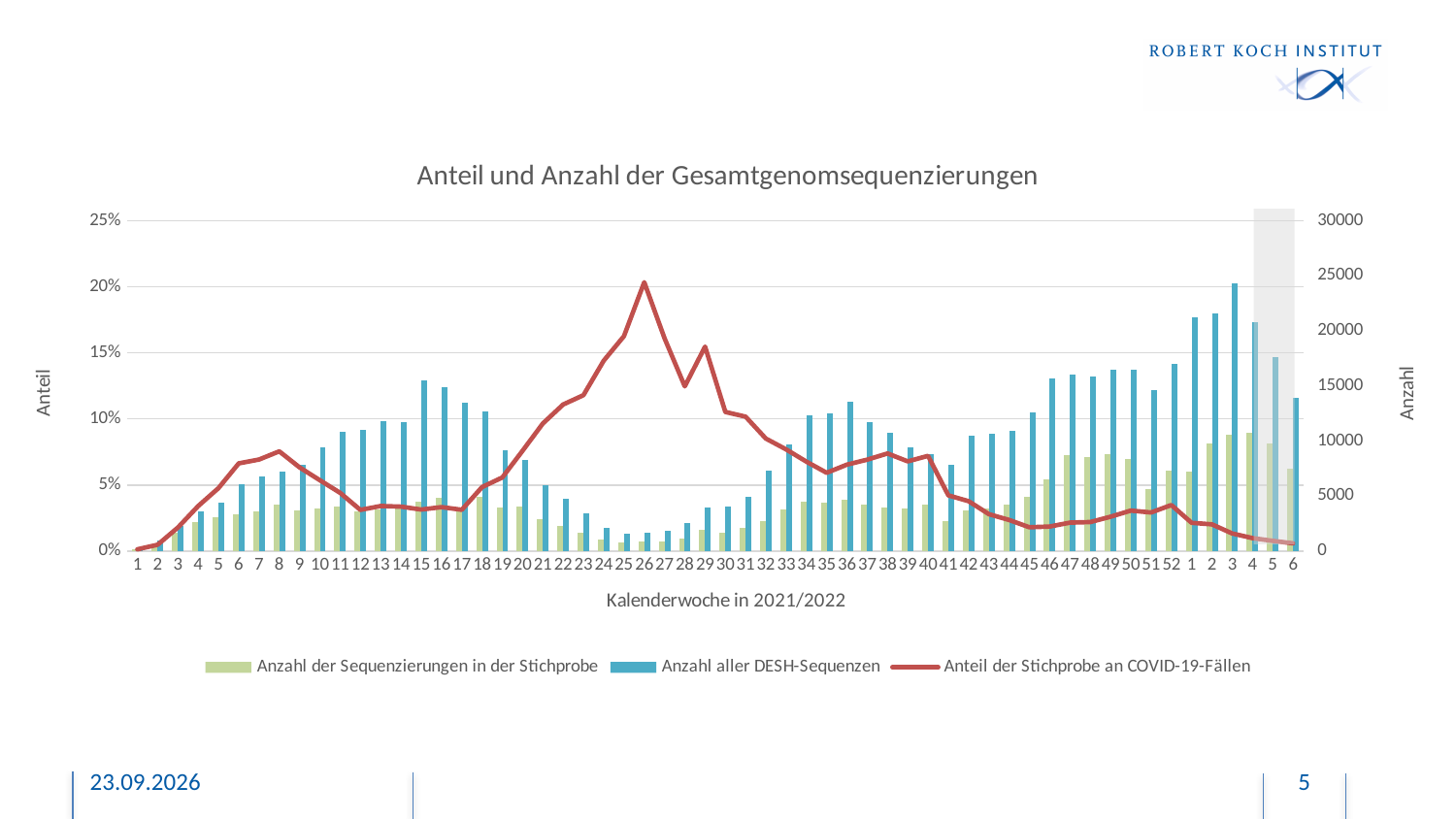
Which series is drawn as a red line? Anteil der Stichprobe an COVID-19-Fällen Is the value of 'Anteil der Stichprobe an COVID-19-Fällen' in calendar week 26 greater or less than 15%? greater Does the line 'Anteil der Stichprobe an COVID-19-Fällen' rise or fall from calendar week 26 to calendar week 6 of 2022? fall What is the title of the chart? Anteil und Anzahl der Gesamtgenomsequenzierungen Is the value of 'Anzahl aller DESH-Sequenzen' in calendar week 26 greater or less than 5000? less Which is larger: 'Anzahl aller DESH-Sequenzen' in calendar week 15 or in calendar week 26? Week 15 How many calendar weeks are shown on the x axis? 58 How many series does the legend list? 3 What kind of chart is shown on the slide? Combined bar and line chart In which calendar week does the line 'Anteil der Stichprobe an COVID-19-Fällen' reach its highest value? 26 Is the value of 'Anteil der Stichprobe an COVID-19-Fällen' in calendar week 6 of 2022 greater or less than 5%? less